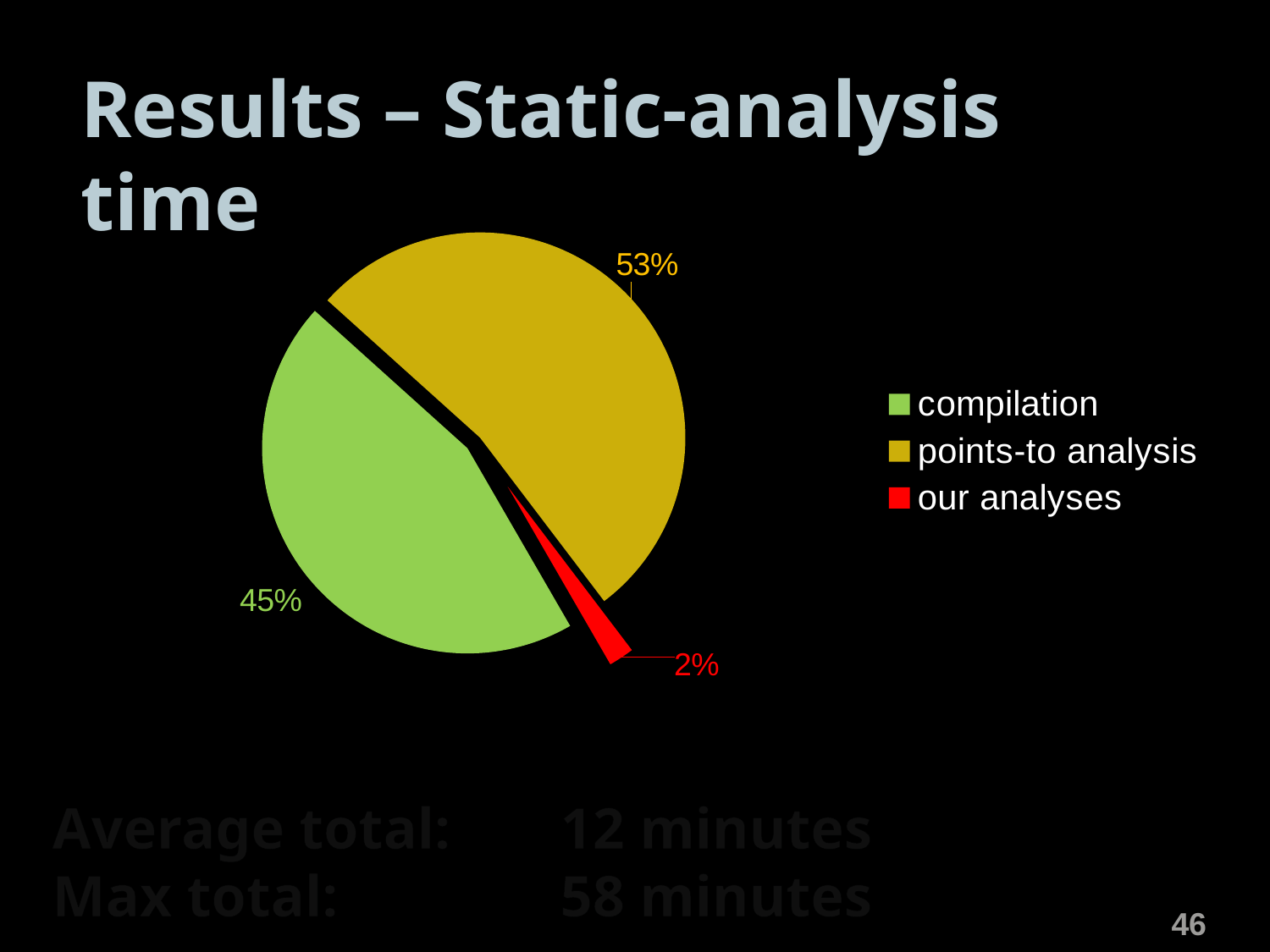
Which category has the largest slice of the pie? points-to analysis What colour is the slice for our analyses? red What share of the pie does points-to analysis take? 53% What share of the pie does our analyses take? 2% What share of the pie does compilation take? 45% What is the difference in percentage points between compilation and our analyses? 43 What kind of chart is shown on the slide? pie chart Which is larger, the slice for compilation or the slice for points-to analysis? points-to analysis How many slices does the pie chart have? 3 What is the difference in percentage points between points-to analysis and compilation? 8 How many entries does the legend list? 3 Which category has the smallest slice of the pie? our analyses